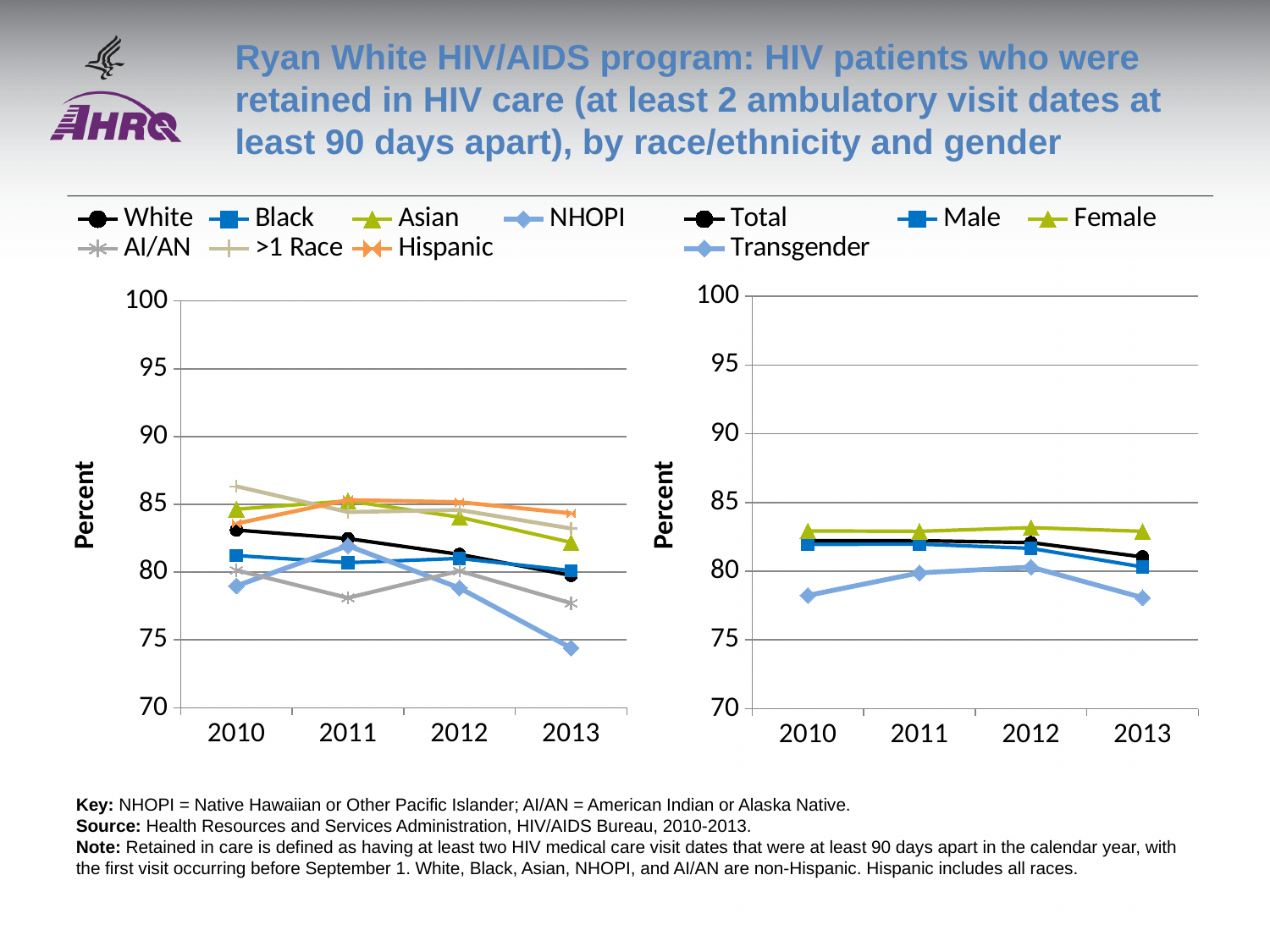
In the right chart (by gender), which group has the lowest value in every year? Transgender In the left chart (by race/ethnicity), which group has the highest value in 2010? >1 Race What kind of chart is the left chart (by race/ethnicity)? Line chart How many series does the legend of the right chart (by gender) list? 4 In the left chart (by race/ethnicity), is the value for >1 Race in 2010 greater or less than 85? greater In the left chart (by race/ethnicity), which group has the lowest value in 2013? NHOPI In the left chart (by race/ethnicity), is the value for NHOPI in 2013 greater or less than 75? less In the right chart (by gender), is the value for Transgender in 2010 greater or less than 80? less In the right chart (by gender), does the Female line rise or fall from 2012 to 2013? Fall How many years are shown on the x axis of the right chart (by gender)? 4 How many series does the legend of the left chart (by race/ethnicity) list? 7 In the left chart (by race/ethnicity), which is larger in 2013, Hispanic or Asian? Hispanic